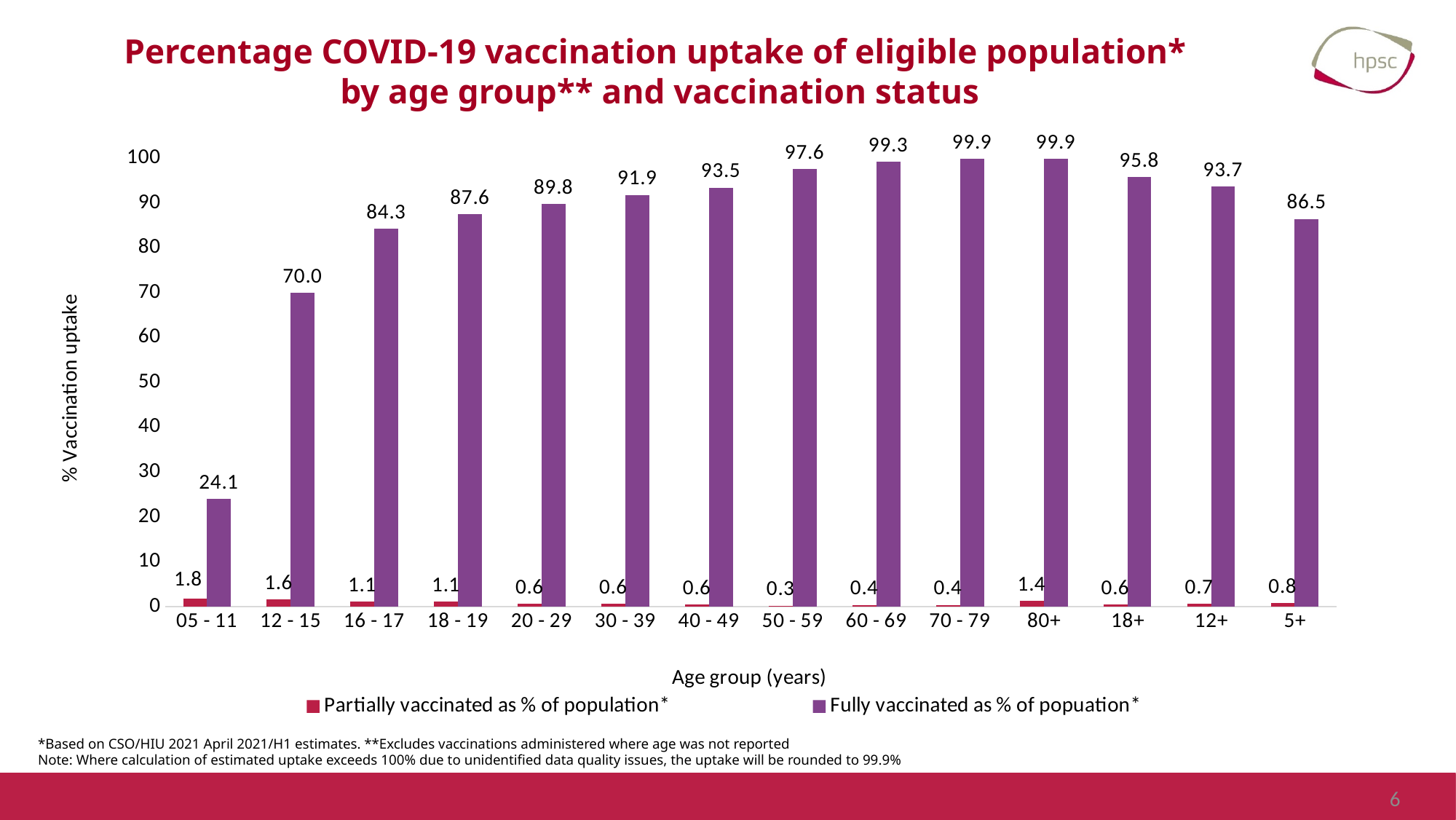
What is the fully vaccinated value for the 5+ age group? 86.5 What is the difference between the fully vaccinated values for the 12 - 15 and 05 - 11 age groups? 45.9 Which age group has the lowest partially vaccinated value? 50 - 59 Which has a higher fully vaccinated value, the 40 - 49 age group or the 50 - 59 age group? 50 - 59 Which age group has the highest partially vaccinated value? 05 - 11 What type of chart is shown on the slide? Bar chart How many age groups are shown on the x axis? 14 Which age group has the lowest fully vaccinated value? 05 - 11 What is the partially vaccinated value for the 80+ age group? 1.4 How many series does the legend list? 2 What is the fully vaccinated value for the 05 - 11 age group? 24.1 What is the difference between the fully vaccinated values for the 18+ and 5+ age groups? 9.3